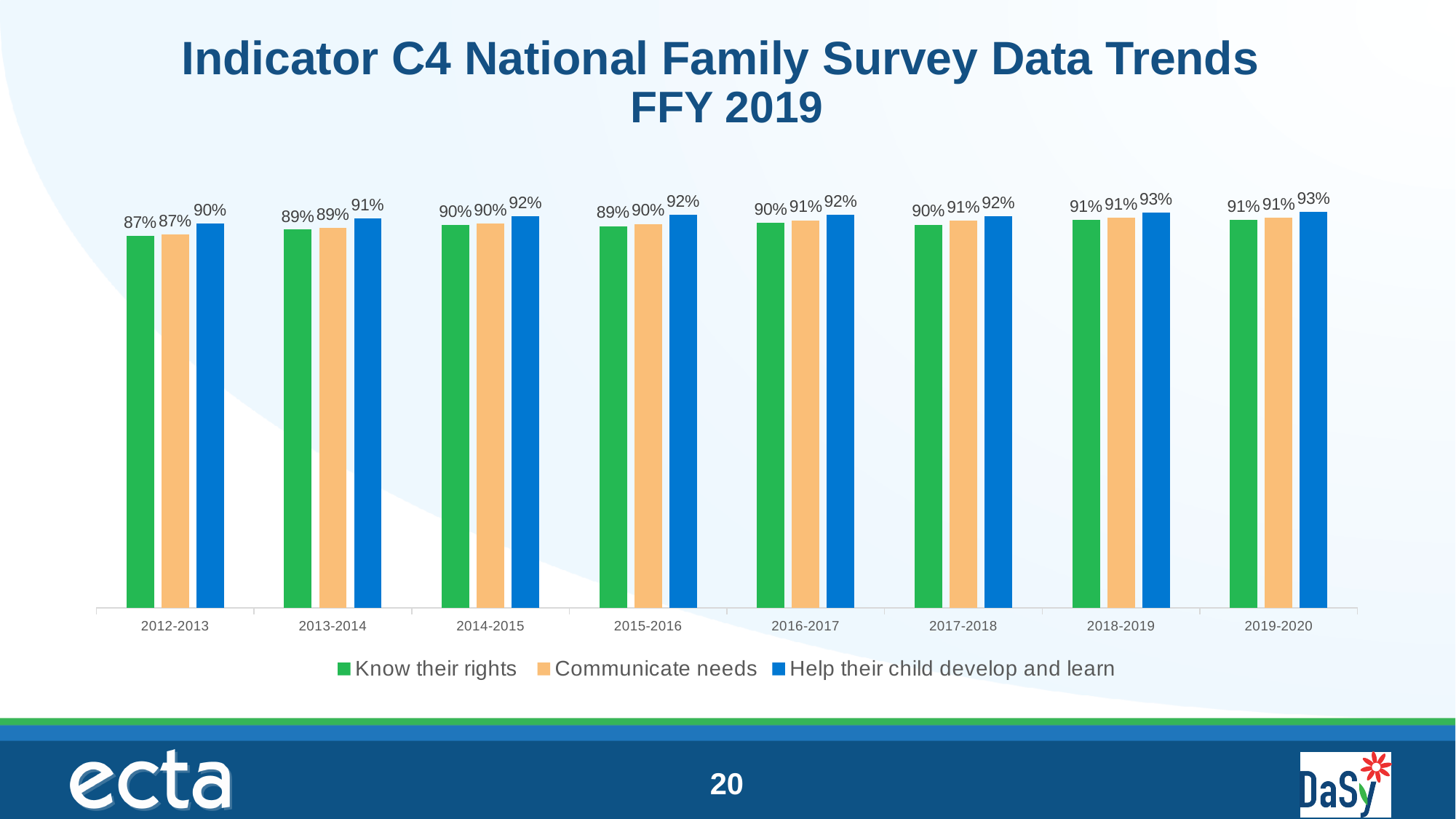
What kind of chart is shown on the slide? Bar chart In which year is the value for "Know their rights" lowest? 2012-2013 What is the value for "Help their child develop and learn" in 2013-2014? 91% What is the difference between "Help their child develop and learn" and "Know their rights" in 2012-2013? 3% What is the value for "Help their child develop and learn" in 2019-2020? 93% How many year categories are shown on the x axis? 8 What is the value for "Know their rights" in 2012-2013? 87% Which is larger in 2015-2016: "Know their rights" or "Help their child develop and learn"? Help their child develop and learn What is the value for "Communicate needs" in 2016-2017? 91% Do the values for "Help their child develop and learn" generally rise or fall from 2012-2013 to 2019-2020? Rise How many series does the legend list? 3 What is the difference between the "Help their child develop and learn" value in 2019-2020 and in 2012-2013? 3%